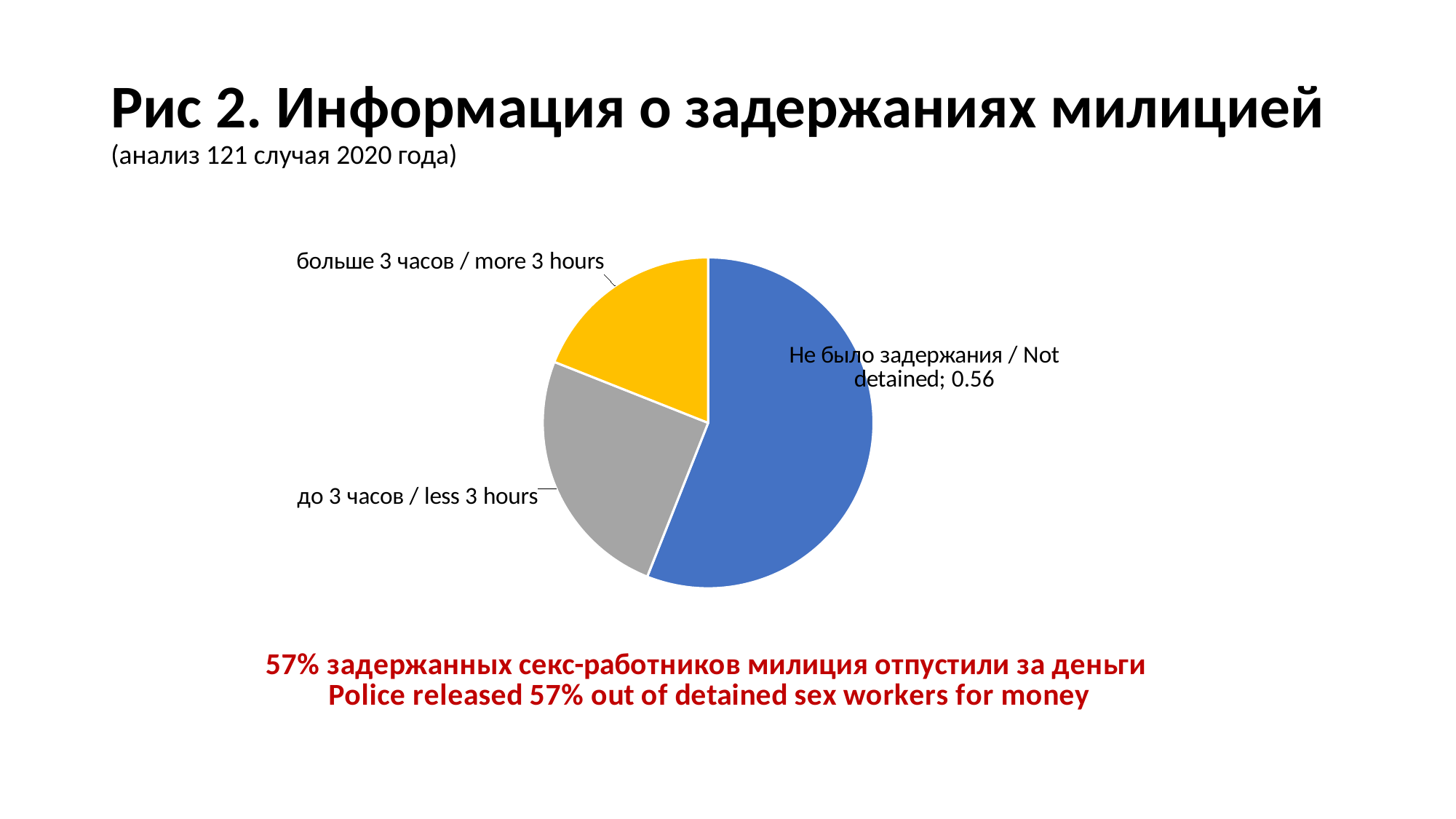
Which slice of the pie chart is the largest? Не было задержания / Not detained Which slice is larger: "Не было задержания / Not detained" or "до 3 часов / less 3 hours"? Не было задержания / Not detained What colour is the "Не было задержания / Not detained" slice? blue Which slice of the pie chart is the smallest? больше 3 часов / more 3 hours Which slice is larger: "до 3 часов / less 3 hours" or "больше 3 часов / more 3 hours"? до 3 часов / less 3 hours What colour is the "больше 3 часов / more 3 hours" slice? yellow What value is shown for the slice "Не было задержания / Not detained"? 0.56 Does the "Не было задержания / Not detained" slice make up more or less than half of the pie? more How many slices does the pie chart have? 3 What kind of chart is shown on the slide? pie chart